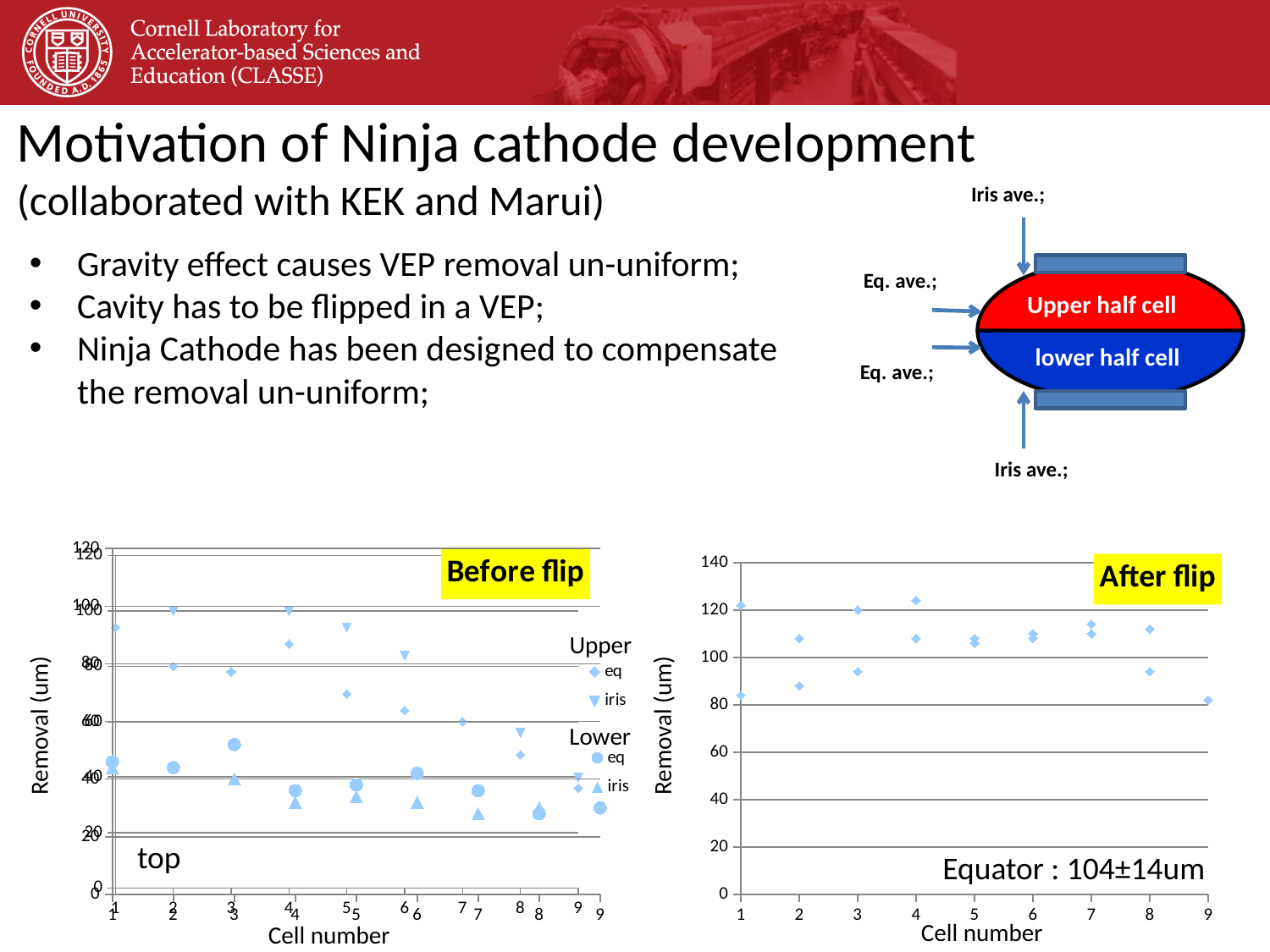
In the "Before flip" chart, is the Lower eq value at cell number 3 greater or less than 40? greater How many cell numbers are shown on the x axis of the "After flip" chart? 9 How many series does the legend of the "Before flip" chart list? 4 In the "Before flip" chart, is the Upper eq value at cell number 1 greater or less than 80? greater In the "Before flip" chart, which cell number has the lowest Upper eq value? 9 In the "After flip" chart, is the lower value at cell number 8 greater or less than 100? less What kind of chart is the "Before flip" chart? scatter chart In the "Before flip" chart, is the Upper eq value larger at cell number 1 or at cell number 9? cell number 1 What equator removal value is annotated on the "After flip" chart? 104±14um In the "Before flip" chart, does the Upper eq series rise or fall from cell number 1 to cell number 9? fall